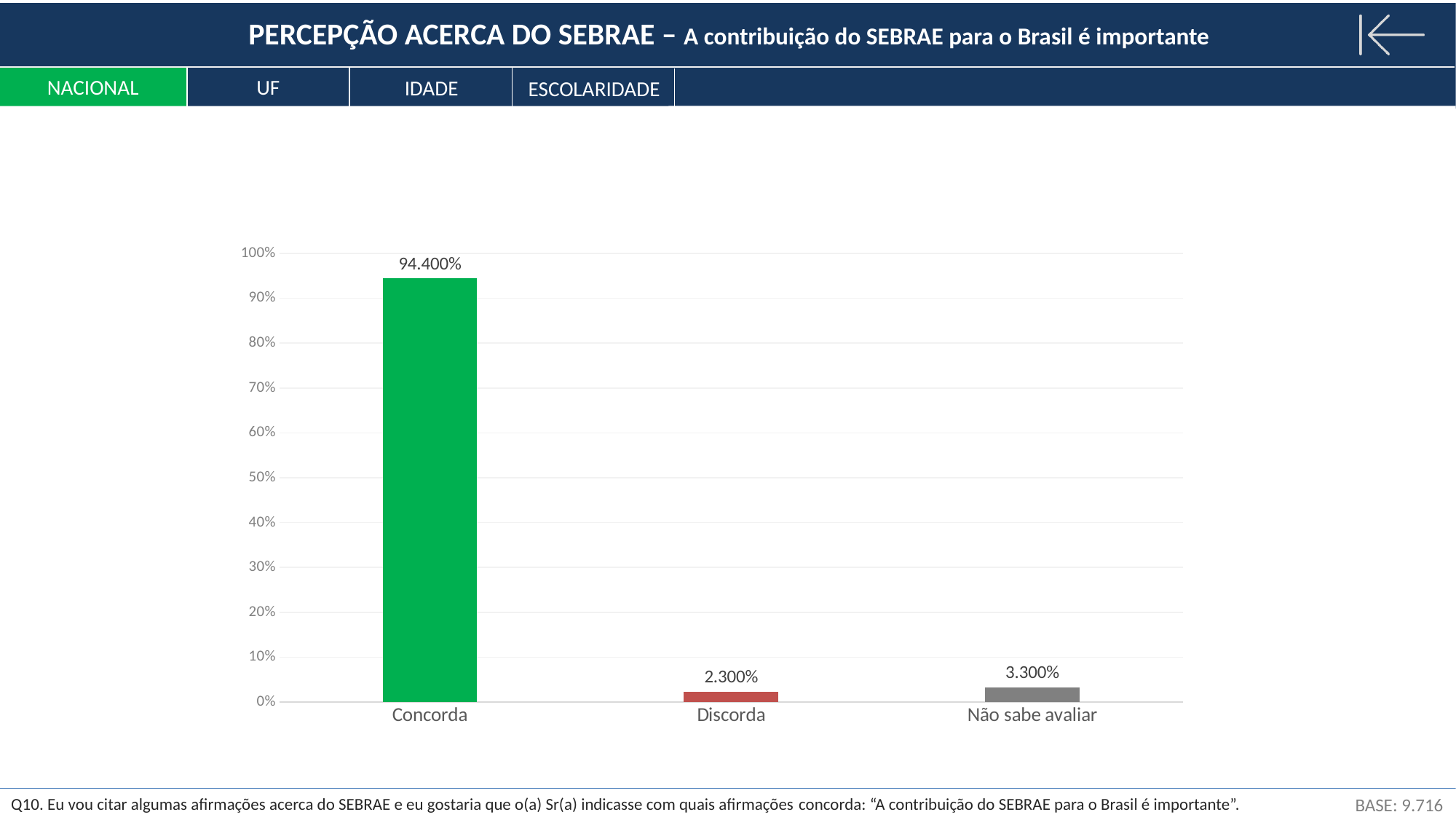
What is the value for Não sabe avaliar? 3.300% Is the value for Concorda greater or less than 90%? greater What is the difference between the values for Concorda and Discorda? 92.100% Which category has the highest value? Concorda What is the value for Concorda? 94.400% Which is larger, the value for Não sabe avaliar or the value for Discorda? Não sabe avaliar What colour is the bar for Concorda? green What is the difference between the values for Não sabe avaliar and Discorda? 1.000% Which category has the lowest value? Discorda How many categories are shown on the x axis? 3 What kind of chart is shown on the slide? bar chart What is the value for Discorda? 2.300%